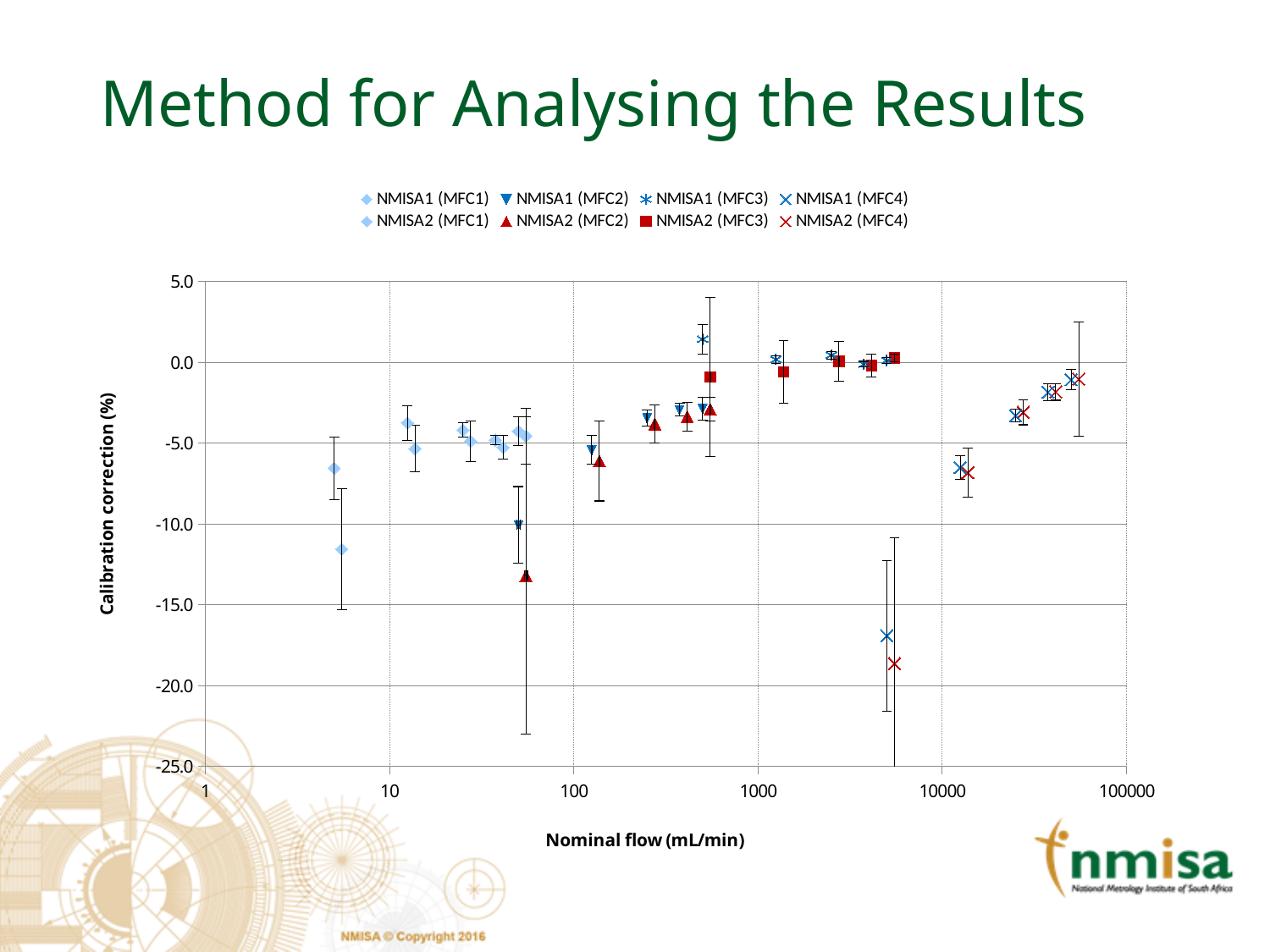
Near 5000 mL/min, which is larger: the NMISA1 (MFC4) value or the NMISA2 (MFC4) value? NMISA1 (MFC4) How many series does the legend list? 8 What is the title of the vertical axis? Calibration correction (%) Near 50 mL/min, which is larger: the NMISA1 (MFC2) value or the NMISA2 (MFC2) value? NMISA1 (MFC2) Is the NMISA2 (MFC3) point near 3000 mL/min greater or less than -5.0? greater Is the lowest NMISA2 (MFC4) point, near 5000 mL/min, greater or less than -15.0? less What is the title of the horizontal axis? Nominal flow (mL/min) Which series has the highest plotted point on the chart? NMISA1 (MFC3) Which series has the lowest plotted point on the chart? NMISA2 (MFC4) Is the lowest NMISA2 (MFC2) point, near 50 mL/min, greater or less than -10.0? less What kind of chart is shown on the slide? scatter chart